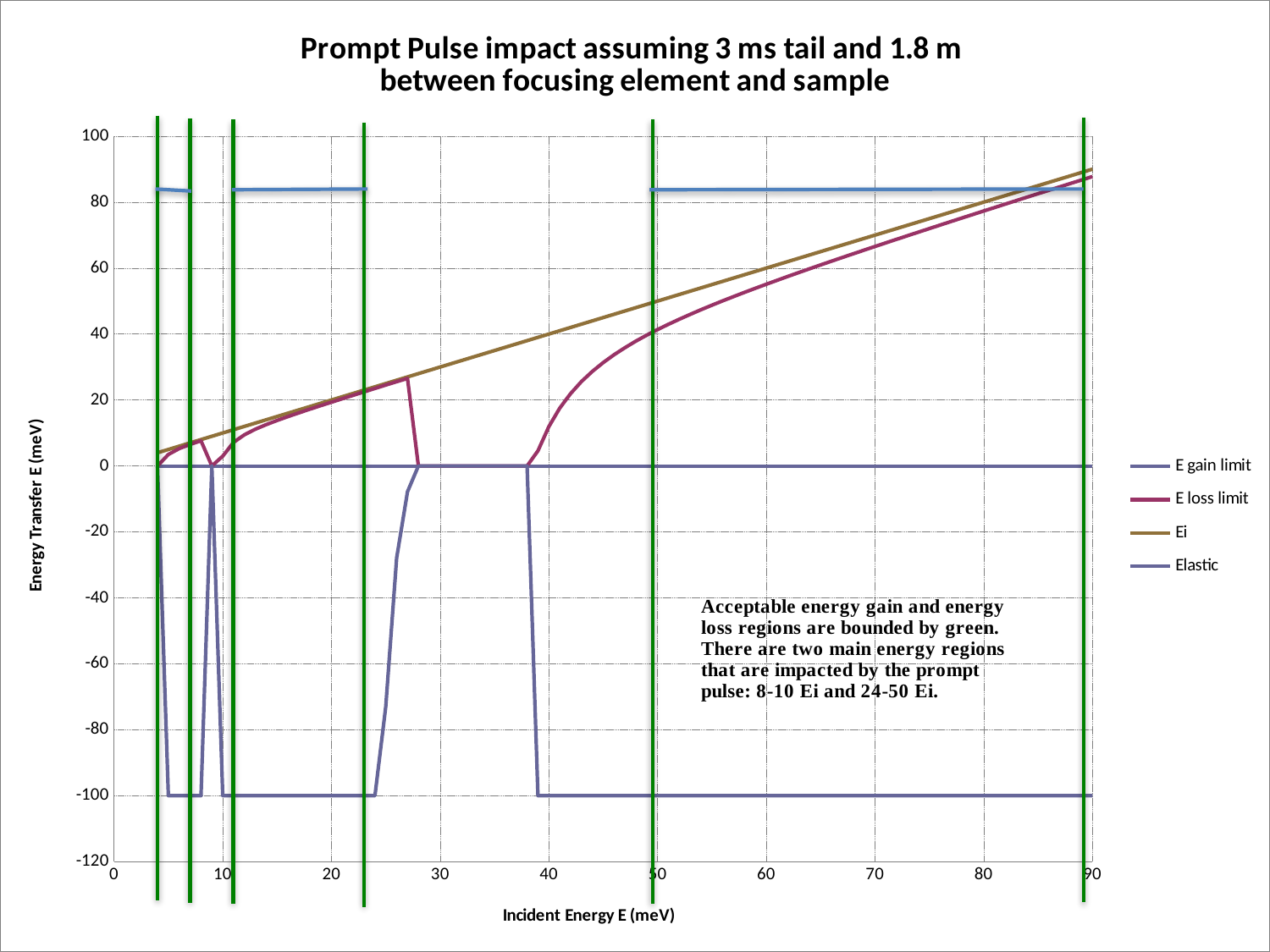
Does the Elastic series rise, fall, or stay flat across the x axis? stays flat How many series does the legend list? 4 Is the value of the E loss limit series at an Incident Energy of 30 meV greater or less than 20? less What kind of chart is shown on the slide? line chart Is the value of the E loss limit series at an Incident Energy of 10 meV greater or less than 40? less Is the value of the E gain limit series at an Incident Energy of 60 meV greater or less than -80? less At an Incident Energy of 50 meV, which series has the higher value, Ei or E loss limit? Ei At an Incident Energy of 20 meV, which series has the higher value, E gain limit or E loss limit? E loss limit Does the Ei series rise or fall as Incident Energy increases? rises What is the title of the chart? Prompt Pulse impact assuming 3 ms tail and 1.8 m between focusing element and sample What is the label of the x axis? Incident Energy E (meV)